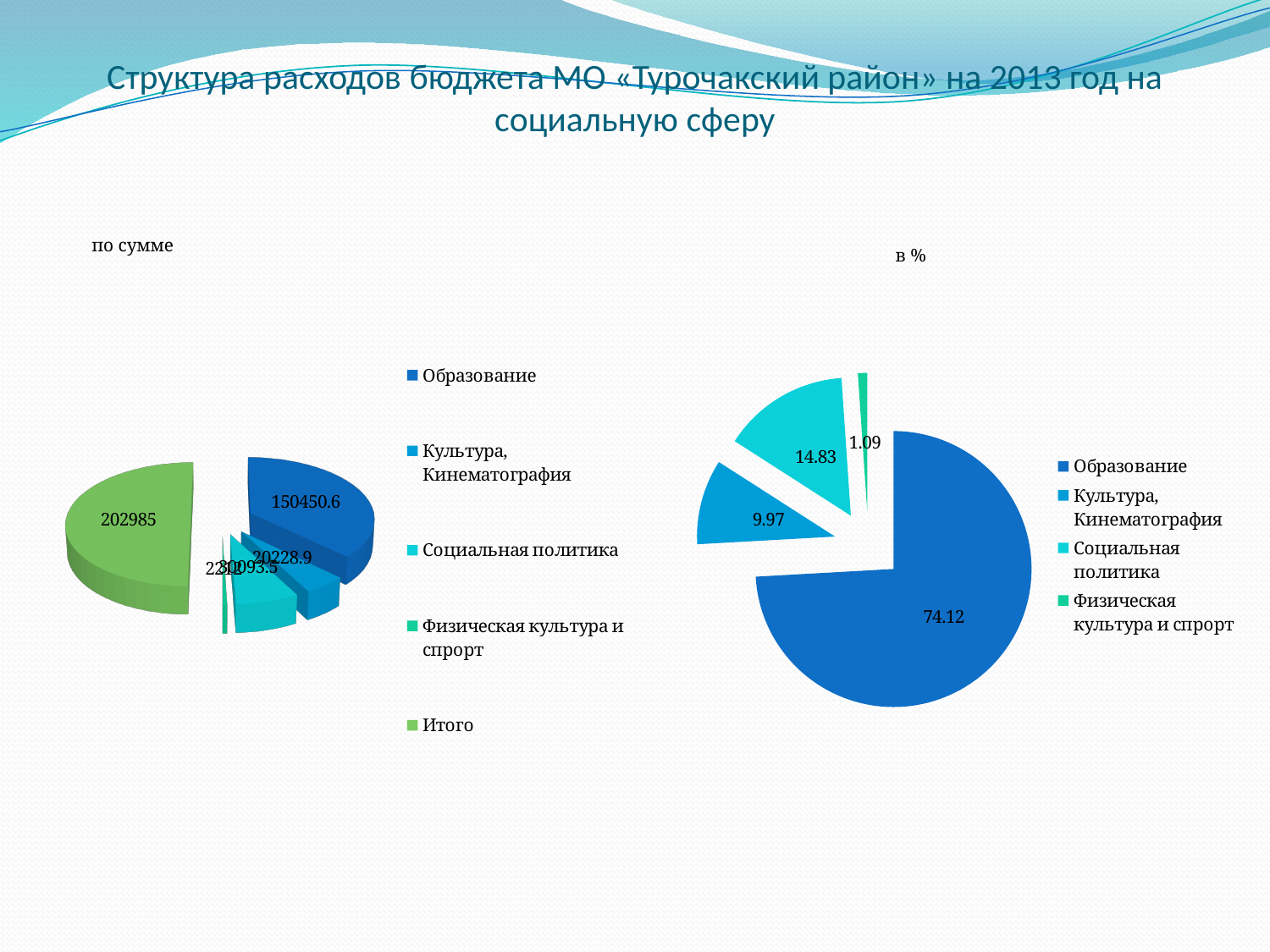
In the chart labelled "по сумме", what is the value for Образование? 150450.6 In the chart labelled "по сумме", what is the value for Итого? 202985 How many categories does the legend of the chart labelled "в %" list? 4 In the chart labelled "в %", which category has the smallest slice? Физическая культура и спрорт In the chart labelled "в %", what is the value for Культура, Кинематография? 9.97 What kind of chart is the chart labelled "в %" on the right of the slide? pie chart In the chart labelled "в %", what is the value for Физическая культура и спрорт? 1.09 In the chart labelled "в %", which category has the largest slice? Образование In the chart labelled "в %", what is the value for Образование? 74.12 How many entries does the legend of the chart labelled "по сумме" list? 5 In the chart labelled "в %", what is the value for Социальная политика? 14.83 In the chart labelled "в %", what is the difference between the values for Социальная политика and Культура, Кинематография? 4.86